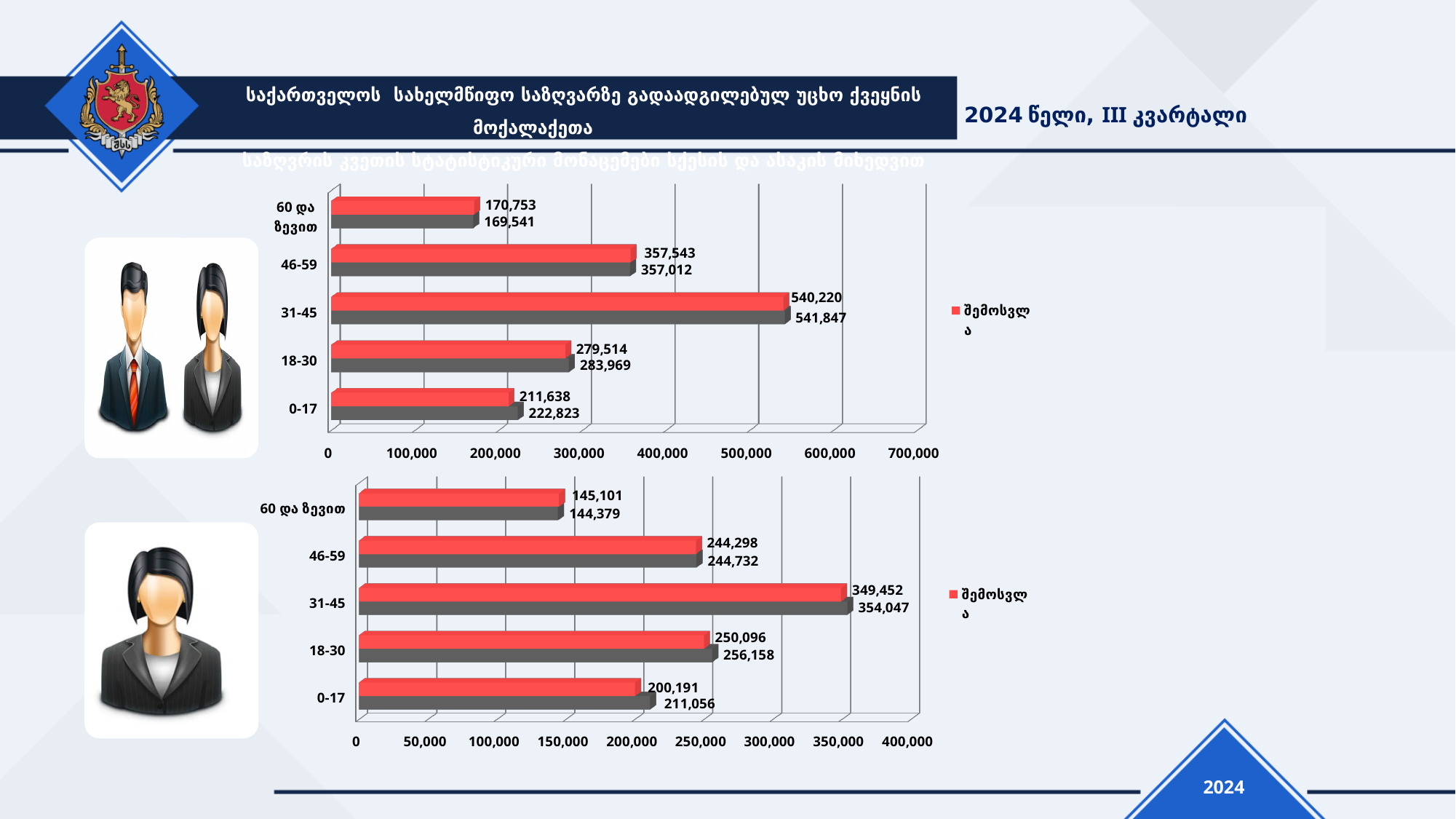
What type of chart is the bottom chart? bar chart On the top chart, what is the value of the grey bar for the 0-17 age group? 222,823 On the bottom chart, which age group has the lowest grey bar value? 60 და ზევით On the top chart, what is the difference between the grey bar and the red bar for the 18-30 age group? 4,455 On the bottom chart, what is the difference between the grey bar and the red bar for the 0-17 age group? 10,865 On the bottom chart, what is the value of the grey bar for the 60 და ზევით age group? 144,379 What is the legend entry shown next to the top chart? შემოსვლა On the top chart, what is the value of the red bar for the 31-45 age group? 540,220 On the bottom chart, what is the value of the red bar for the 18-30 age group? 250,096 How many age groups are shown on the top chart? 5 On the top chart, which age group has the highest red bar value? 31-45 On the bottom chart, which is larger for the 31-45 age group: the red bar or the grey bar? the grey bar